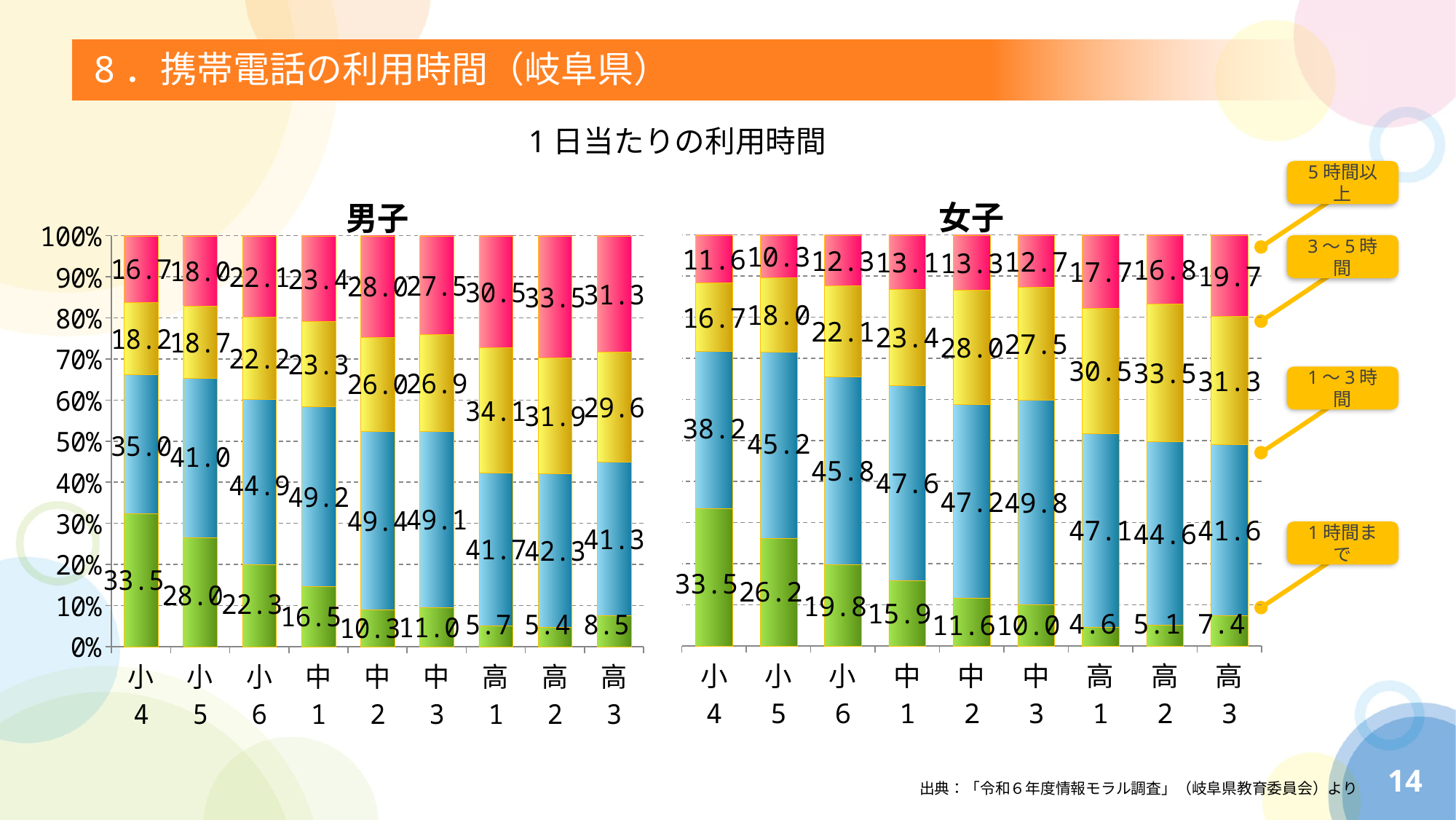
How many categories are shown on the x axis of the 男子 chart? 9 How many series does the legend list for the charts? 4 In the 男子 chart, what is the difference between the 1時間まで values for 小4 and 高3? 25.0 In the 男子 chart, what is the value of the 1時間まで segment for 小4? 33.5 In the 女子 chart, which is larger: the 1～3時間 value for 中3 or for 高3? 中3 In the 男子 chart, does the 1時間まで value generally rise or fall from 小4 to 高1? Fall In the 女子 chart, which category has the lowest value for the 1時間まで segment? 高1 In the 男子 chart, which category has the highest value for the 5時間以上 segment? 高2 What kind of chart is the 女子 chart? Stacked bar chart In the 女子 chart, what is the value of the 5時間以上 segment for 高3? 19.7 In the 男子 chart, what is the value of the 1～3時間 segment for 中2? 49.4 What is the title of the left chart? 男子